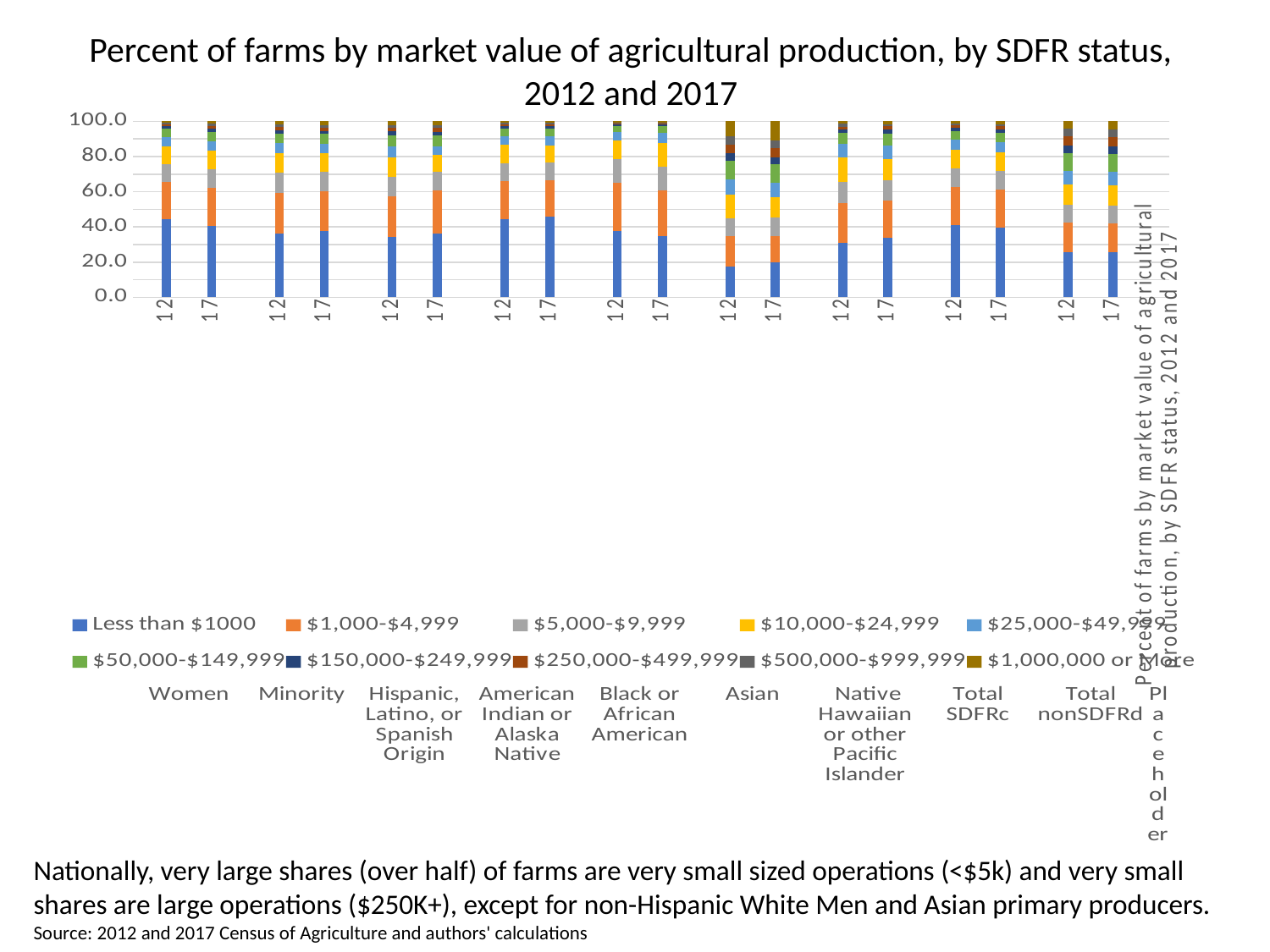
How many series does the legend list? 10 How many bars are plotted in total on the chart? 18 Which bar has the smallest 'Less than $1000' segment? Asian, 2012 How many producer groups are shown along the x axis? 9 Is the 'Less than $1000' value for Women in 2012 greater or less than 40? greater Is the 'Less than $1000' value for Asian in 2012 greater or less than 20? less What kind of chart is shown on the slide? Stacked bar chart Is the 'Less than $1000' value for Native Hawaiian or other Pacific Islander in 2012 greater or less than 40? less Which has the larger 'Less than $1000' share: Women in 2012 or Asian in 2012? Women in 2012 What is the title of the chart? Percent of farms by market value of agricultural production, by SDFR status, 2012 and 2017 Which legend entry is shown in blue at the bottom of each stacked bar? Less than $1000